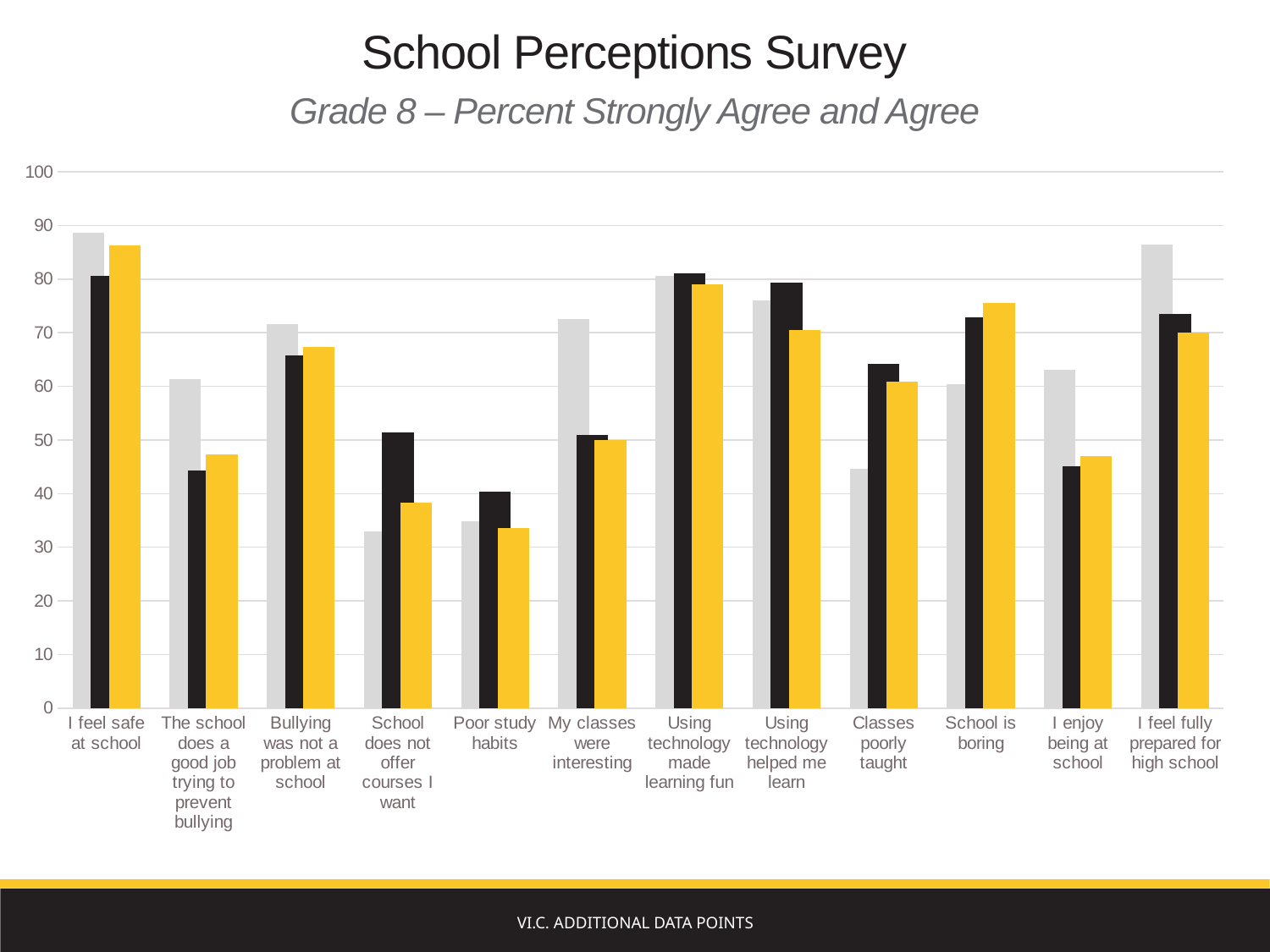
Which survey statement has the highest grey bar? I feel safe at school What is the title of the chart? School Perceptions Survey Is the black bar for "I enjoy being at school" greater or less than 50? less For "My classes were interesting", which is larger: the grey bar or the black bar? The grey bar What kind of chart is shown on the slide? Bar chart Is the grey bar for "I feel safe at school" greater or less than 80? greater Is the yellow bar for "Poor study habits" greater or less than 40? less How many survey statements (categories) are shown along the x axis? 12 What is the subtitle shown under the chart title? Grade 8 – Percent Strongly Agree and Agree How many bars are plotted for each survey statement? 3